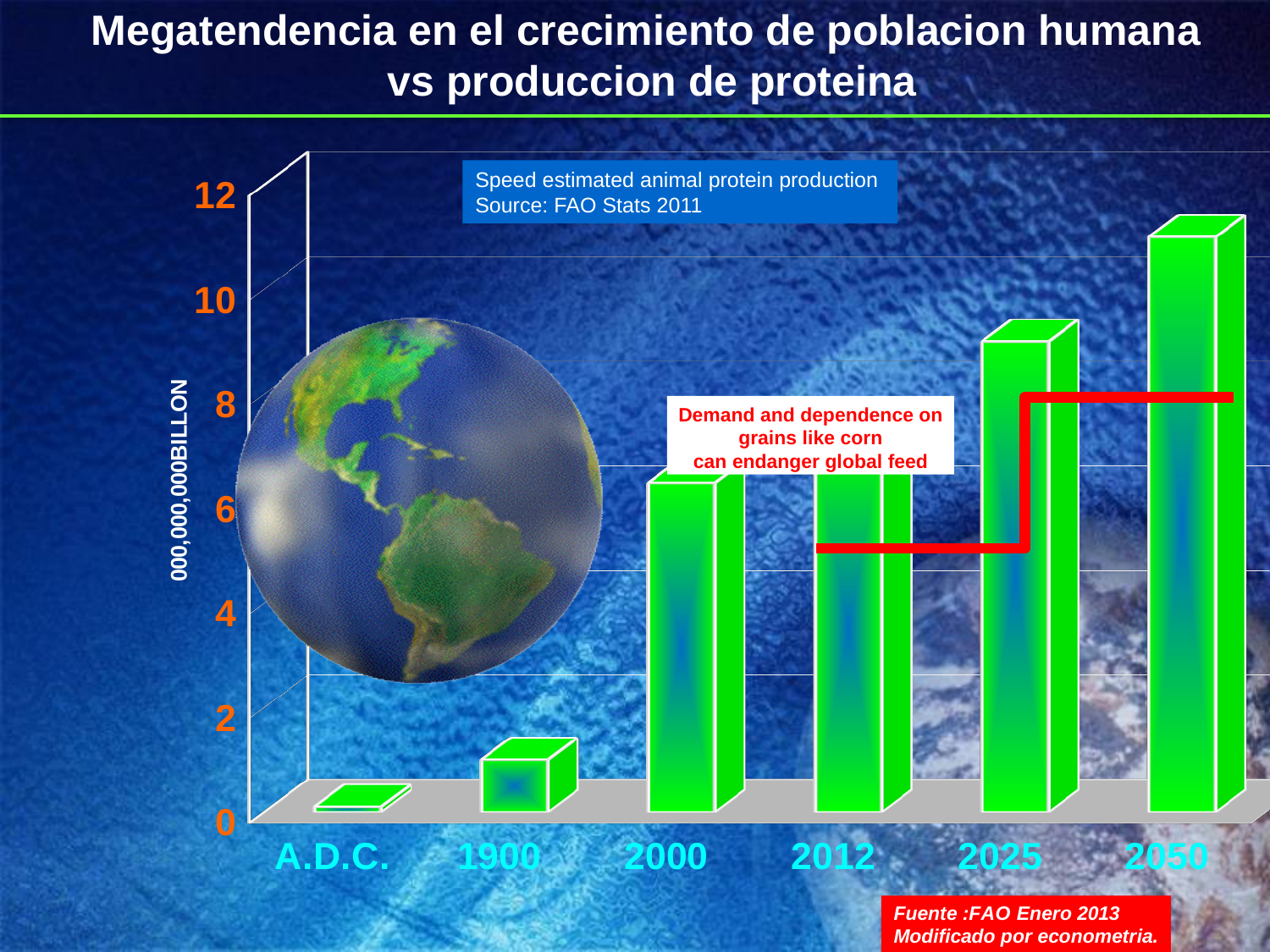
Do the bar values generally rise or fall from A.D.C. to 2050? rise How many categories are shown along the x axis of the chart? 6 Is the value for 1900 greater or less than 2? less Which is larger, the value for 2025 or the value for 2000? 2025 Is the value for 2012 greater or less than 8? less Is the value for 2025 greater or less than 8? greater Which category has the highest bar in the chart? 2050 What is the highest value shown on the y axis of the chart? 12 What kind of chart is shown on the slide? bar chart Which category has the lowest bar in the chart? A.D.C.